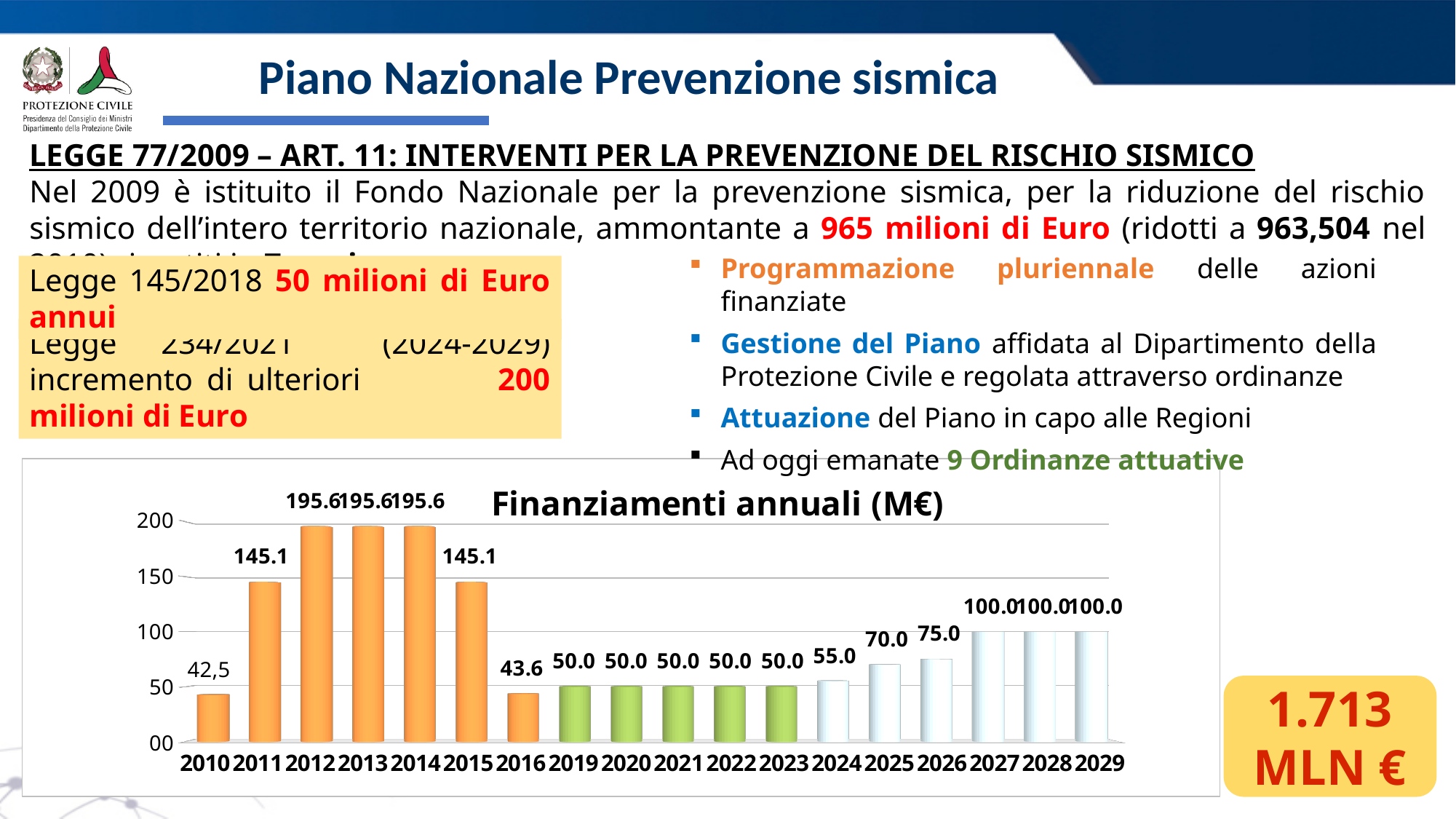
What type of chart is shown on the slide? bar chart What is the value for 2025 in the chart? 70.0 Which is larger, the value for 2015 or the value for 2026? 2015 What is the value for 2011 in the chart? 145.1 What is the title of the chart? Finanziamenti annuali (M€) Which year has the lowest value in the chart? 2010 What is the difference between the values for 2026 and 2025? 5.0 What is the highest value shown in the chart? 195.6 Do the values rise or fall from 2024 to 2029? rise What is the value for 2016 in the chart? 43.6 What is the difference between the values for 2027 and 2024? 45.0 How many years are shown on the x axis of the chart? 18